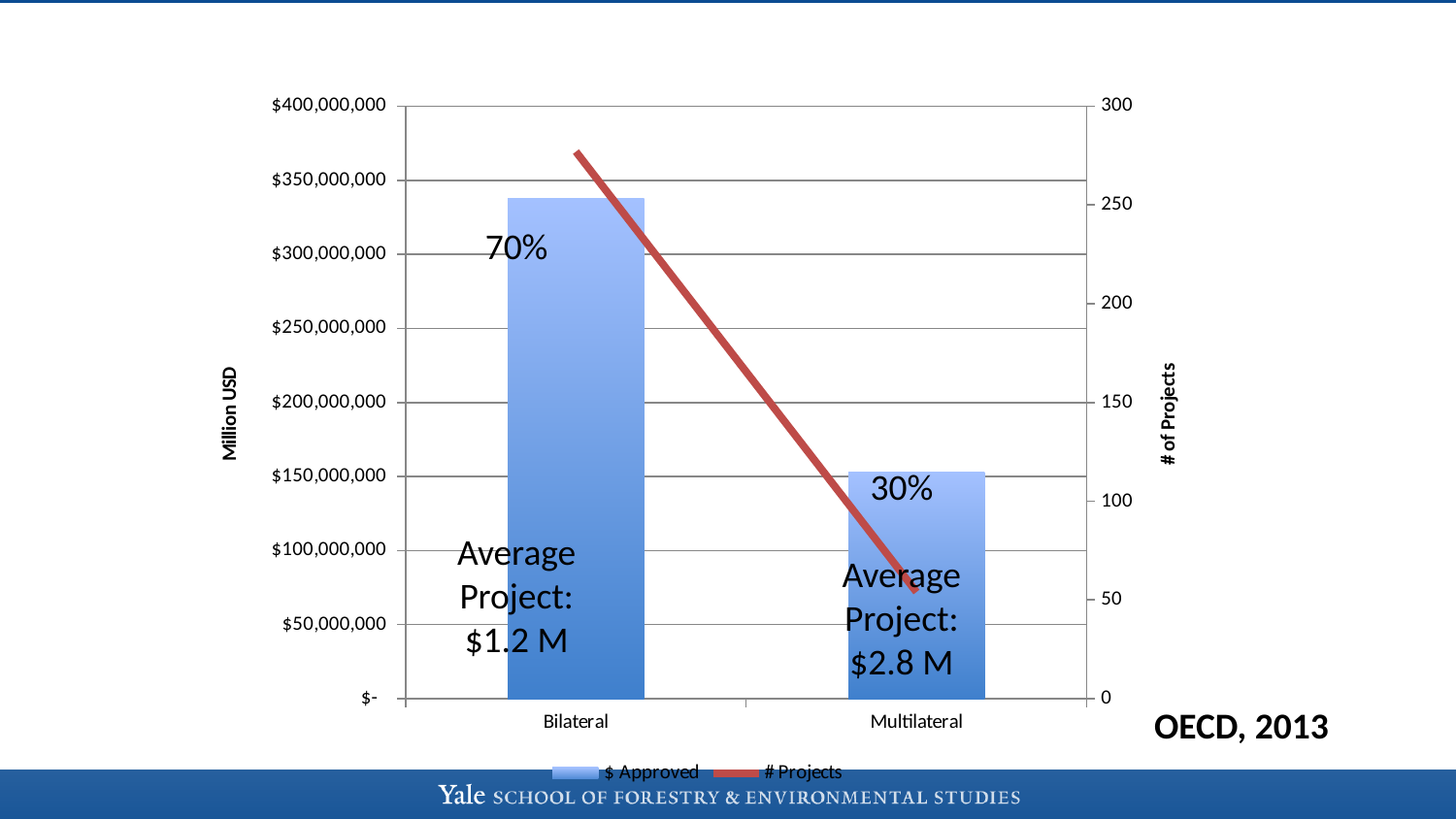
Is the # Projects value for Multilateral greater or less than 100? less Does the # Projects line rise or fall from Bilateral to Multilateral? fall What is the average project size shown for Multilateral? $2.8 M Which category has the lower $ Approved bar? Multilateral How many series does the legend list? 2 Which category has the higher $ Approved bar? Bilateral What percentage label is shown on the Bilateral bar? 70% What kind of chart is shown on the slide? A bar chart combined with a line Is the $ Approved value for Multilateral greater or less than $200,000,000? less How many categories are shown on the x axis? 2 Is the $ Approved value for Bilateral greater or less than $300,000,000? greater